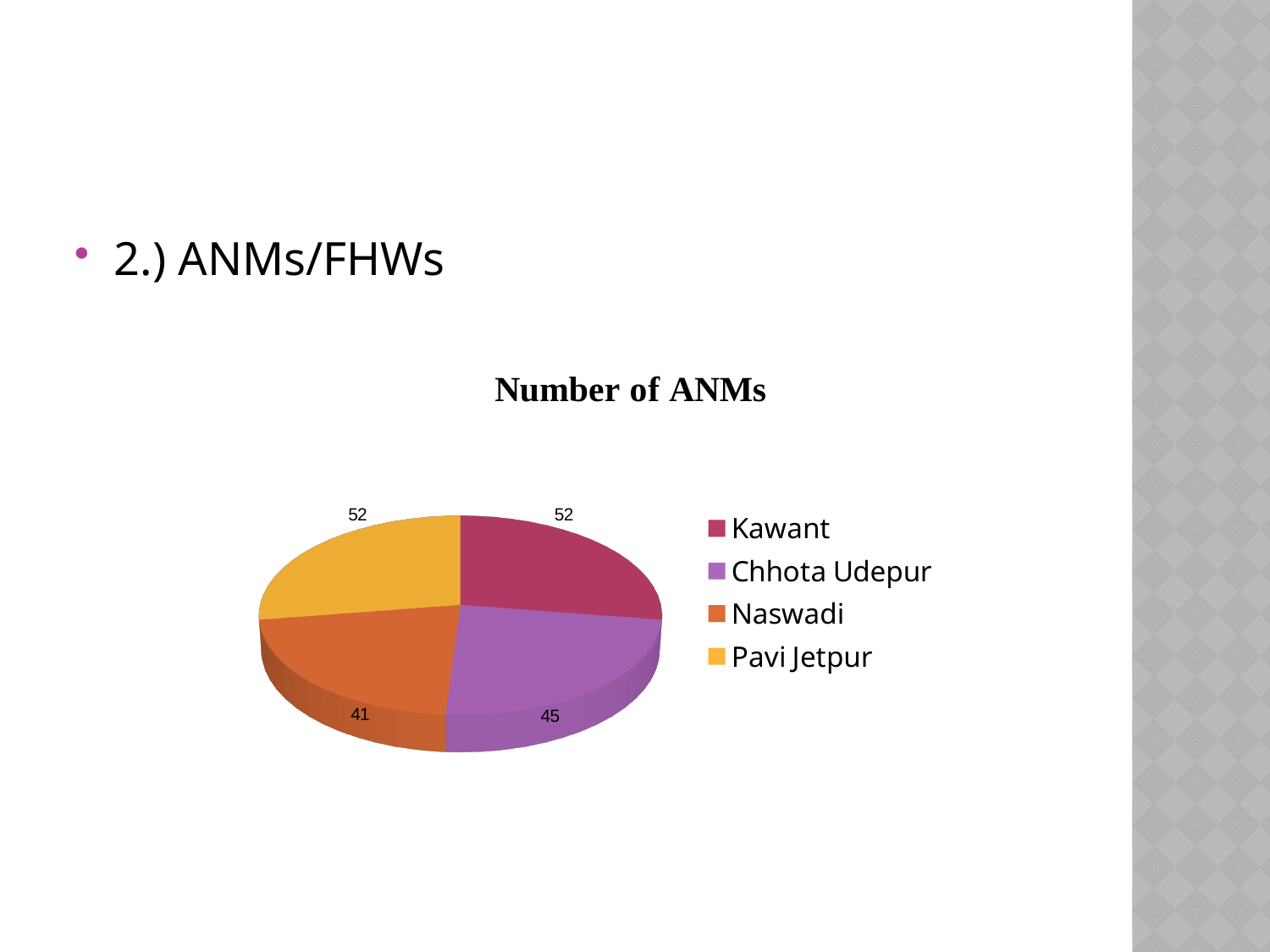
What is the number of ANMs for Chhota Udepur? 45 How many categories does the pie chart show? 4 What is the number of ANMs for Pavi Jetpur? 52 What is the difference between the number of ANMs for Kawant and Naswadi? 11 Which legend entry is shown in yellow? Pavi Jetpur Which has more ANMs, Chhota Udepur or Naswadi? Chhota Udepur Which category has the lowest number of ANMs? Naswadi What is the total number of ANMs across all four categories? 190 What is the title of the chart? Number of ANMs What kind of chart is shown on the slide? Pie chart What is the number of ANMs for Kawant? 52 What is the number of ANMs for Naswadi? 41